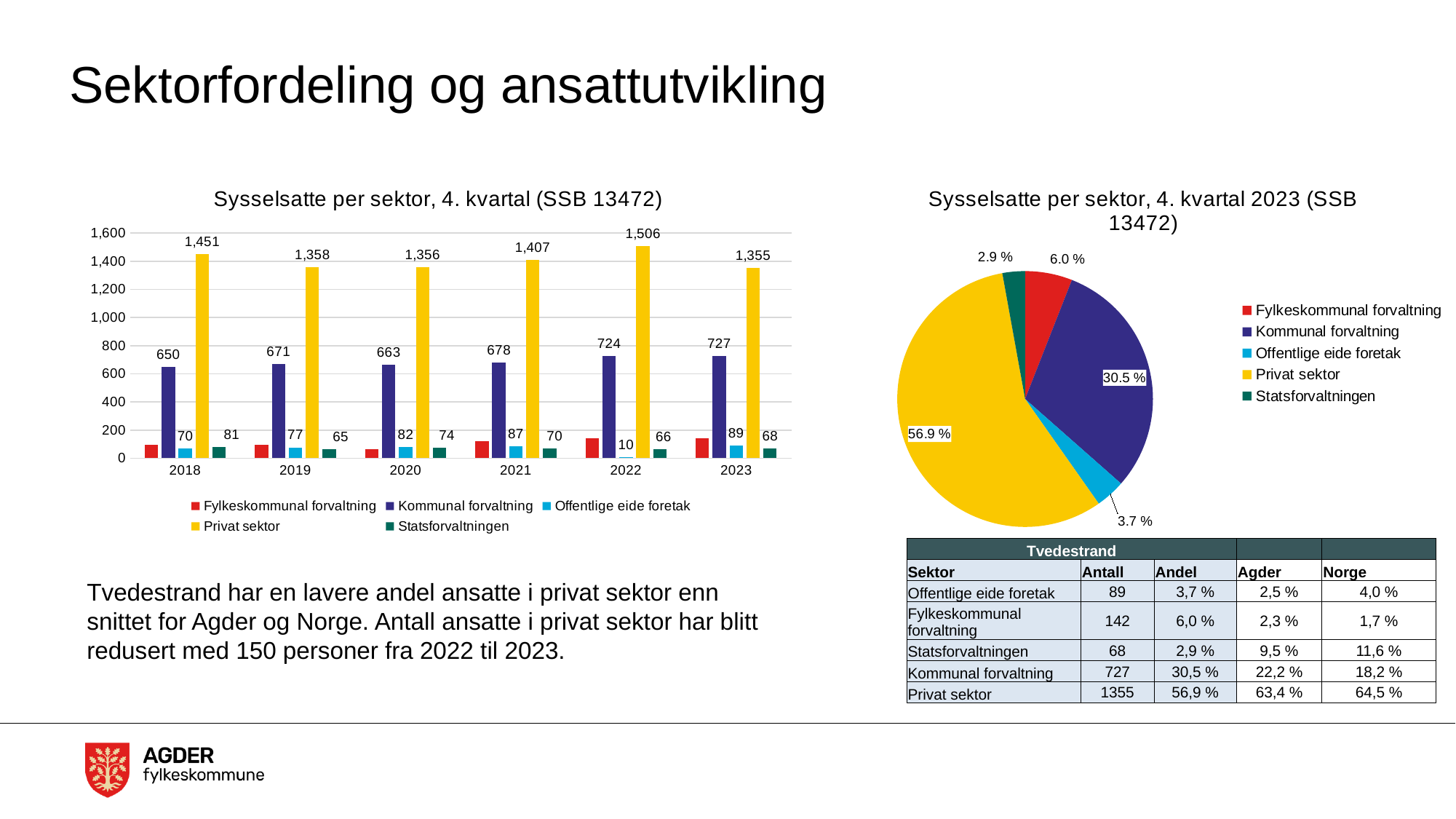
How many series does the legend of the bar chart 'Sysselsatte per sektor, 4. kvartal (SSB 13472)' list? 5 In the bar chart 'Sysselsatte per sektor, 4. kvartal (SSB 13472)', in which year is Privat sektor highest? 2022 In the pie chart 'Sysselsatte per sektor, 4. kvartal 2023 (SSB 13472)', which sector has the smallest slice? Statsforvaltningen What kind of chart is the left chart 'Sysselsatte per sektor, 4. kvartal (SSB 13472)'? bar chart In the pie chart 'Sysselsatte per sektor, 4. kvartal 2023 (SSB 13472)', what share does Privat sektor have? 56.9 % In the bar chart 'Sysselsatte per sektor, 4. kvartal (SSB 13472)', what is the value for Privat sektor in 2022? 1,506 In the bar chart 'Sysselsatte per sektor, 4. kvartal (SSB 13472)', is the value for Fylkeskommunal forvaltning in 2023 greater or less than 200? less In the bar chart 'Sysselsatte per sektor, 4. kvartal (SSB 13472)', what is the difference between Privat sektor in 2022 and in 2023? 151 In the bar chart 'Sysselsatte per sektor, 4. kvartal (SSB 13472)', what is the value for Kommunal forvaltning in 2018? 650 How many years are shown on the x axis of the bar chart 'Sysselsatte per sektor, 4. kvartal (SSB 13472)'? 6 In the bar chart 'Sysselsatte per sektor, 4. kvartal (SSB 13472)', in which year is Statsforvaltningen lowest? 2019 In the bar chart 'Sysselsatte per sektor, 4. kvartal (SSB 13472)', which is larger: Kommunal forvaltning in 2018 or in 2023? 2023